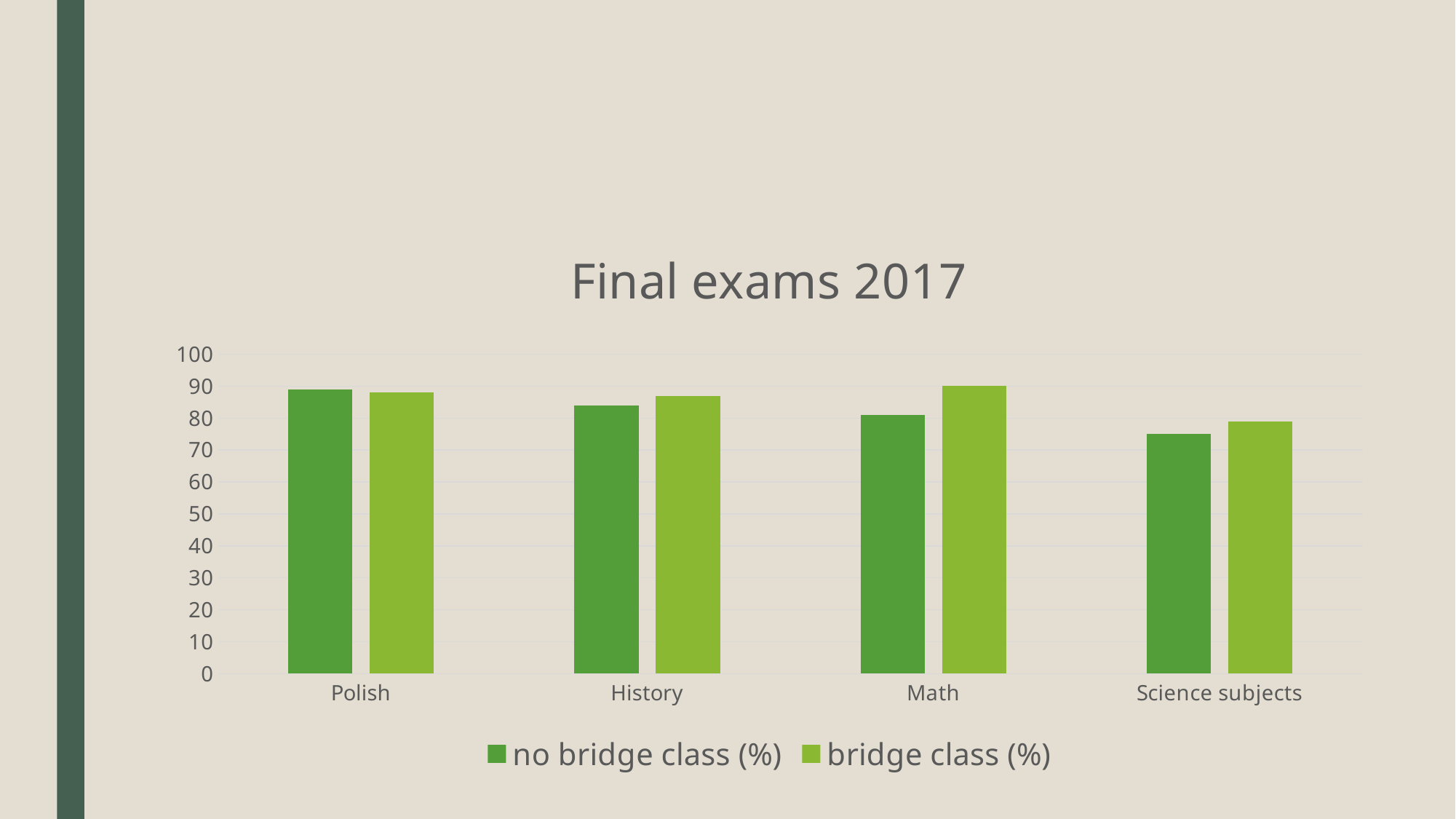
What type of chart is shown on the slide? bar chart How many series does the legend list? 2 Which category has the lowest value for the bridge class (%) series? Science subjects For Science subjects, which series has the larger value: no bridge class (%) or bridge class (%)? bridge class (%) What is the title of the chart? Final exams 2017 Is the value for Polish in the no bridge class (%) series greater or less than 80? greater Which category has the highest value for the no bridge class (%) series? Polish For Math, which series has the larger value: no bridge class (%) or bridge class (%)? bridge class (%) Which category has the lowest value for the no bridge class (%) series? Science subjects Is the value for History in the bridge class (%) series greater or less than 80? greater Is the value for Science subjects in the no bridge class (%) series greater or less than 80? less How many subject categories are shown on the x axis? 4